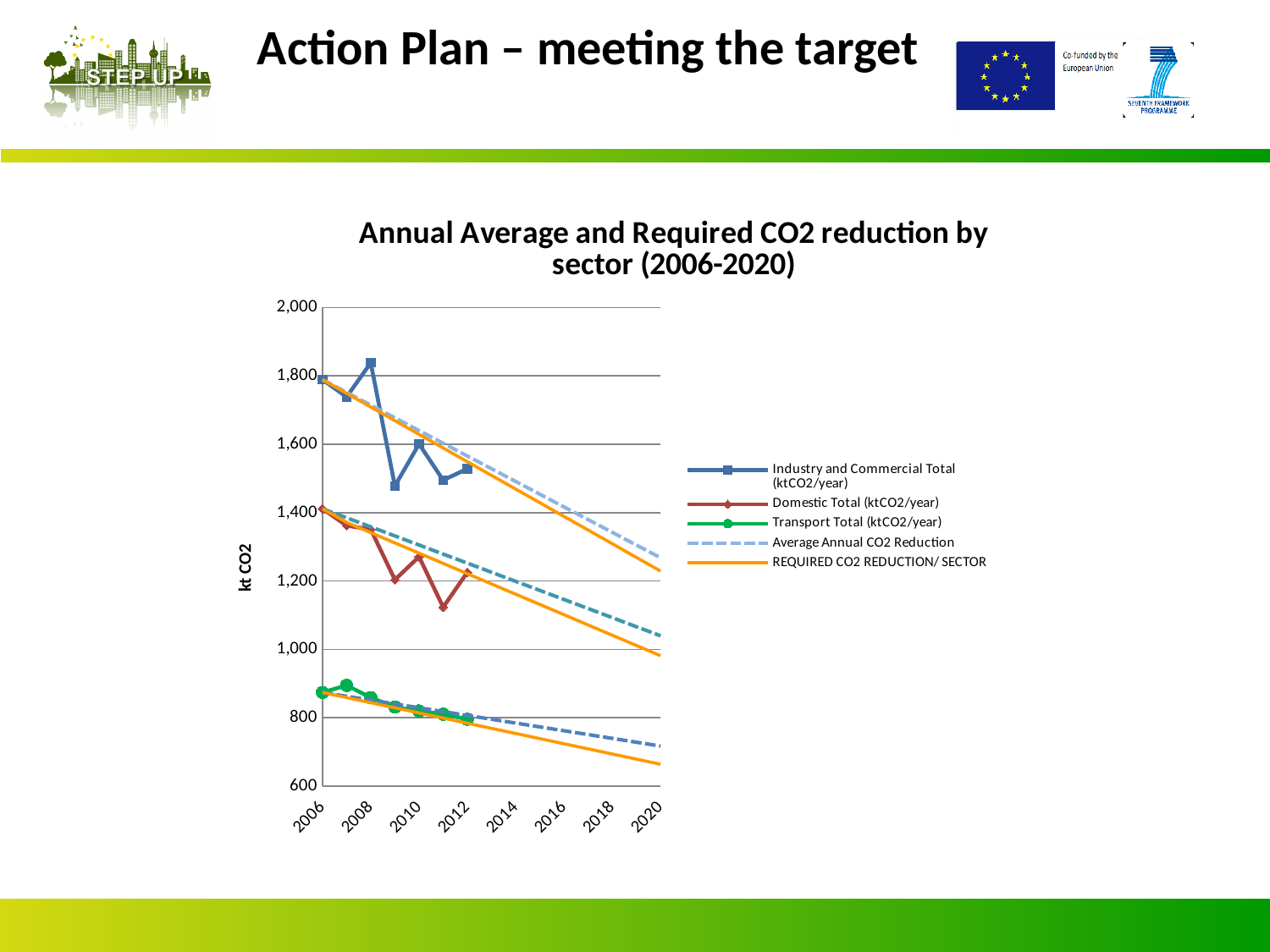
Is the value for Domestic Total in 2011 greater or less than 1,200? less Is the value for Industry and Commercial Total in 2009 greater or less than 1,600? less Which series has the lowest values on the chart? Transport Total (ktCO2/year) In 2006, which is larger: Industry and Commercial Total or Domestic Total? Industry and Commercial Total Is the value for Industry and Commercial Total in 2008 greater or less than 1,800? greater How many series does the legend list? 5 Which series has the highest values on the chart? Industry and Commercial Total (ktCO2/year) What kind of chart is shown on the slide? line chart What is the label on the vertical axis? kt CO2 Does the Transport Total series rise or fall from 2006 to 2012? fall What is the title of the chart? Annual Average and Required CO2 reduction by sector (2006-2020)